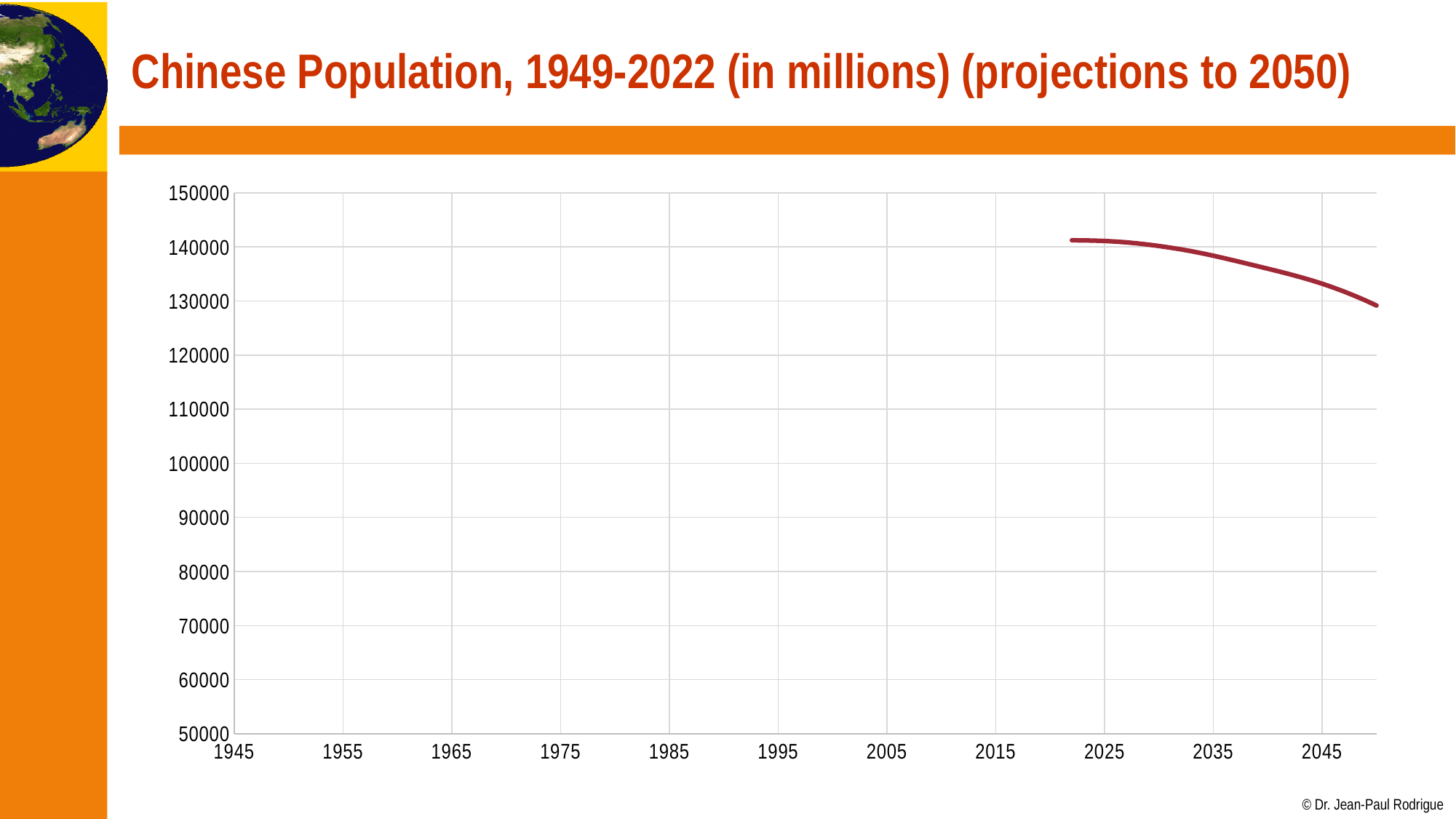
What kind of chart is shown on the slide? line chart Which is larger, the value plotted at the start of the line (around 2022) or the value at the end of the line (around 2050)? the value around 2022 What is the title of the chart on the slide? Chinese Population, 1949-2022 (in millions) (projections to 2050) What is the highest value shown on the vertical axis? 150000 Is the value plotted at the end of the line (around 2050) greater or less than 120000? greater Is the value plotted at the start of the line (around 2022) greater or less than 130000? greater Is the value plotted at the end of the line (around 2050) greater or less than 140000? less What is the lowest value shown on the vertical axis? 50000 Does the plotted line rise or fall as the years increase from 2022 to 2050? fall